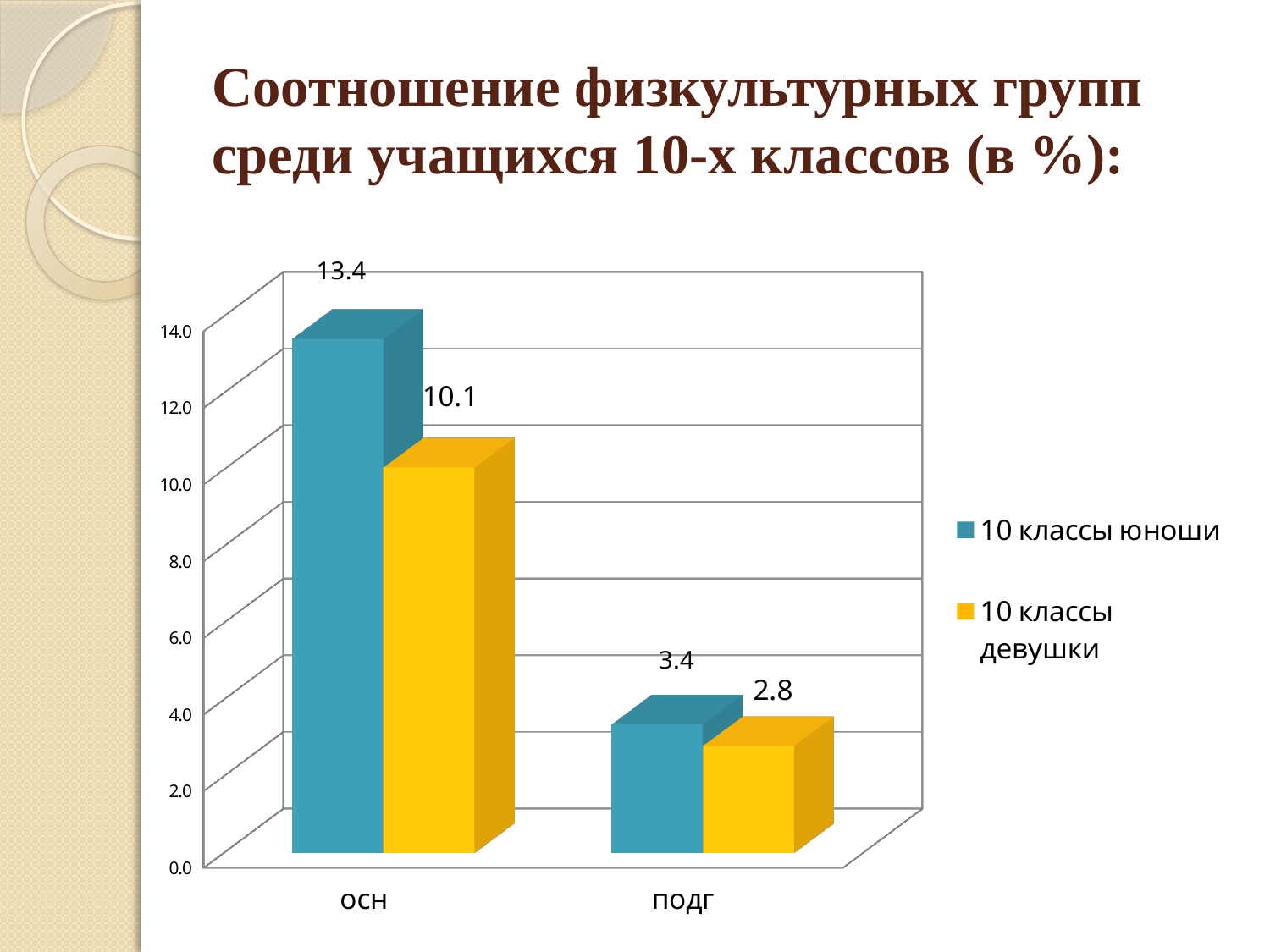
What kind of chart is shown on the slide? Bar chart What is the value for "10 классы юноши" in the "осн" category? 13.4 What is the difference between the "10 классы юноши" and "10 классы девушки" values in the "осн" category? 3.3 Which category has the highest value for "10 классы юноши"? осн How many categories are shown on the x axis? 2 What is the value for "10 классы девушки" in the "подг" category? 2.8 How many series does the legend list? 2 What is the value for "10 классы юноши" in the "подг" category? 3.4 What is the value for "10 классы девушки" in the "осн" category? 10.1 Which colour represents the "10 классы девушки" series? Yellow In the "подг" category, which series has the larger value, "10 классы юноши" or "10 классы девушки"? 10 классы юноши Which category has the lowest value for "10 классы девушки"? подг